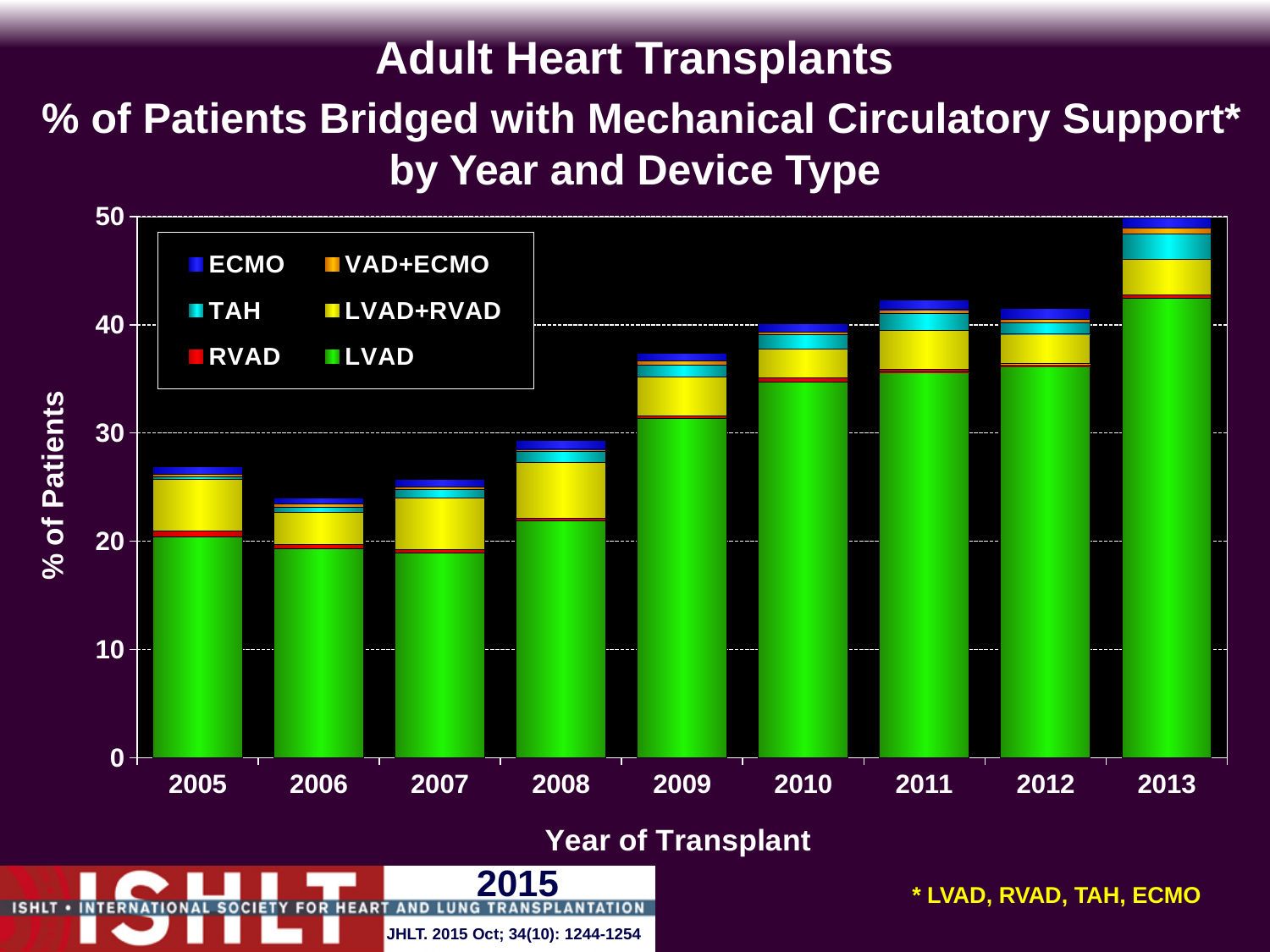
What kind of chart is shown on the slide? Stacked bar chart Which year has a larger total bar, 2005 or 2013? 2013 How many years are shown on the x axis of the chart? 9 Is the total value for 2005 greater or less than 30? less Which year has a larger total bar, 2006 or 2009? 2009 Is the total value for 2009 greater or less than 30? greater What is the title of the x axis? Year of Transplant Is the total value for 2006 greater or less than 30? less Do the total bar heights generally rise or fall from 2005 to 2013? rise How many device types does the legend list? 6 Which year has the highest total percentage of patients bridged with mechanical circulatory support? 2013